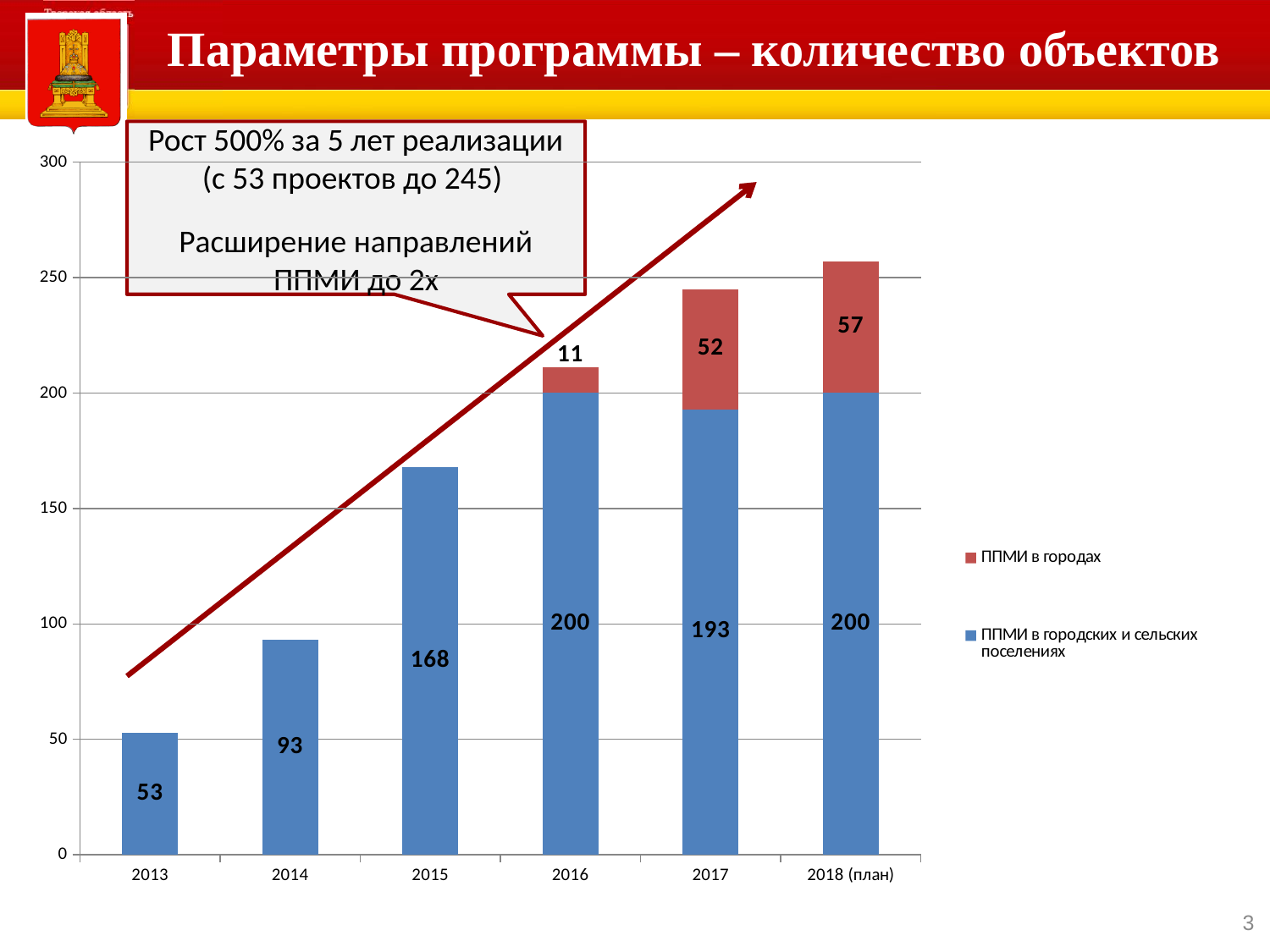
Which year has the highest value for ППМИ в городах? 2018 (план) What is the difference between the ППМИ в городских и сельских поселениях values for 2015 and 2014? 75 How many series does the legend list? 2 Which is larger: ППМИ в городах in 2016 or in 2017? 2017 Which year has the lowest value for ППМИ в городских и сельских поселениях? 2013 What is the value for ППМИ в городских и сельских поселениях in 2015? 168 What is the value for ППМИ в городах in 2017? 52 What is the value for ППМИ в городах in 2018 (план)? 57 What is the value for ППМИ в городских и сельских поселениях in 2013? 53 What is the total of the stacked bar for 2016? 211 What kind of chart is shown on the slide? Stacked bar chart What is the total of the stacked bar for 2017? 245